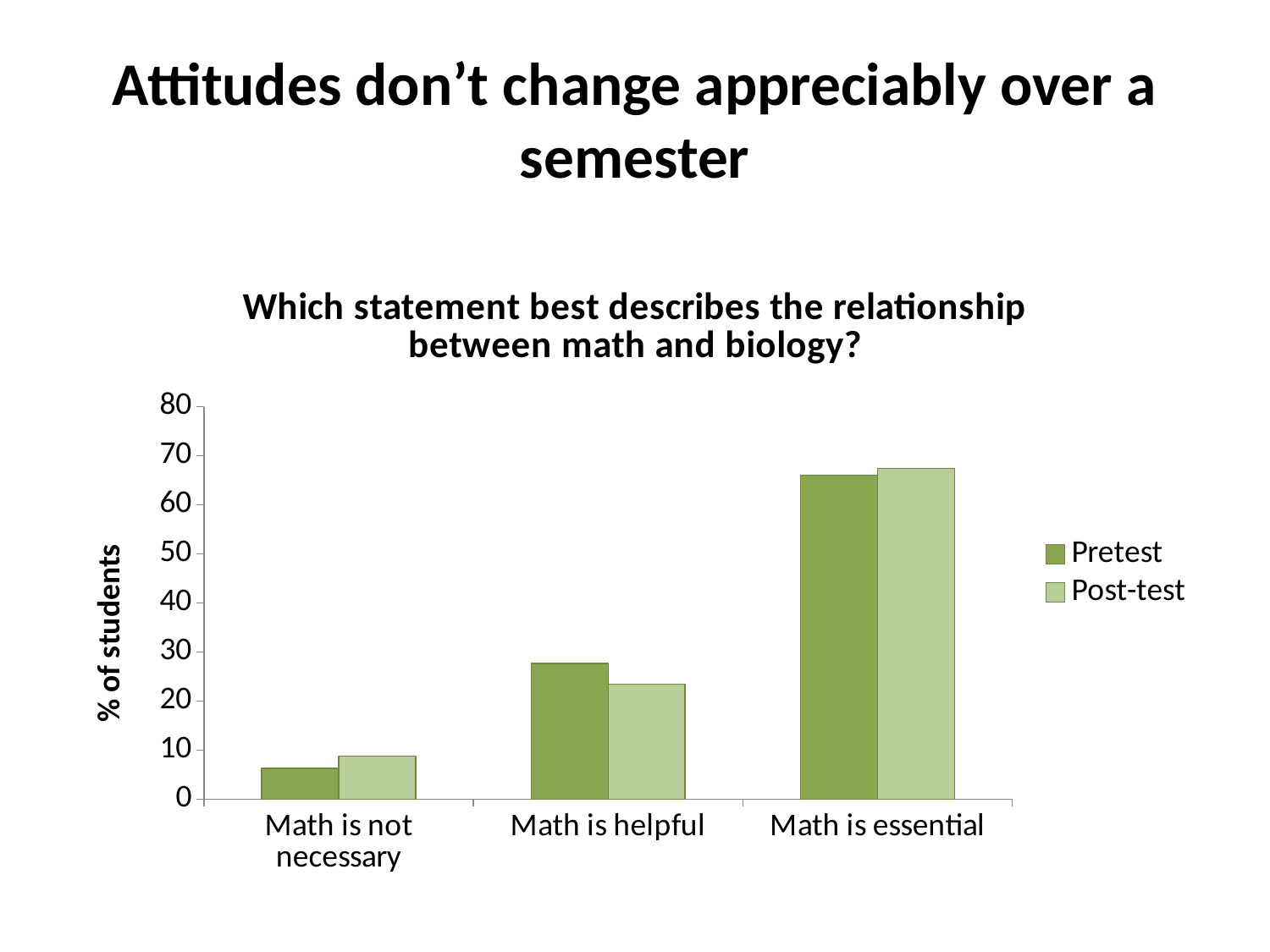
What kind of chart is shown on the slide? bar chart Is the Pretest value for Math is helpful greater or less than 20? greater Is the Pretest value for Math is not necessary greater or less than 10? less Is the Post-test value for Math is essential greater or less than 60? greater For Math is helpful, which is larger, the Pretest or the Post-test value? Pretest How many series does the legend list? 2 Which category has the lowest Post-test value? Math is not necessary Which category has the highest Pretest value? Math is essential How many categories are shown on the x axis? 3 For Math is not necessary, which is larger, the Pretest or the Post-test value? Post-test What is the label on the y axis of the chart? % of students